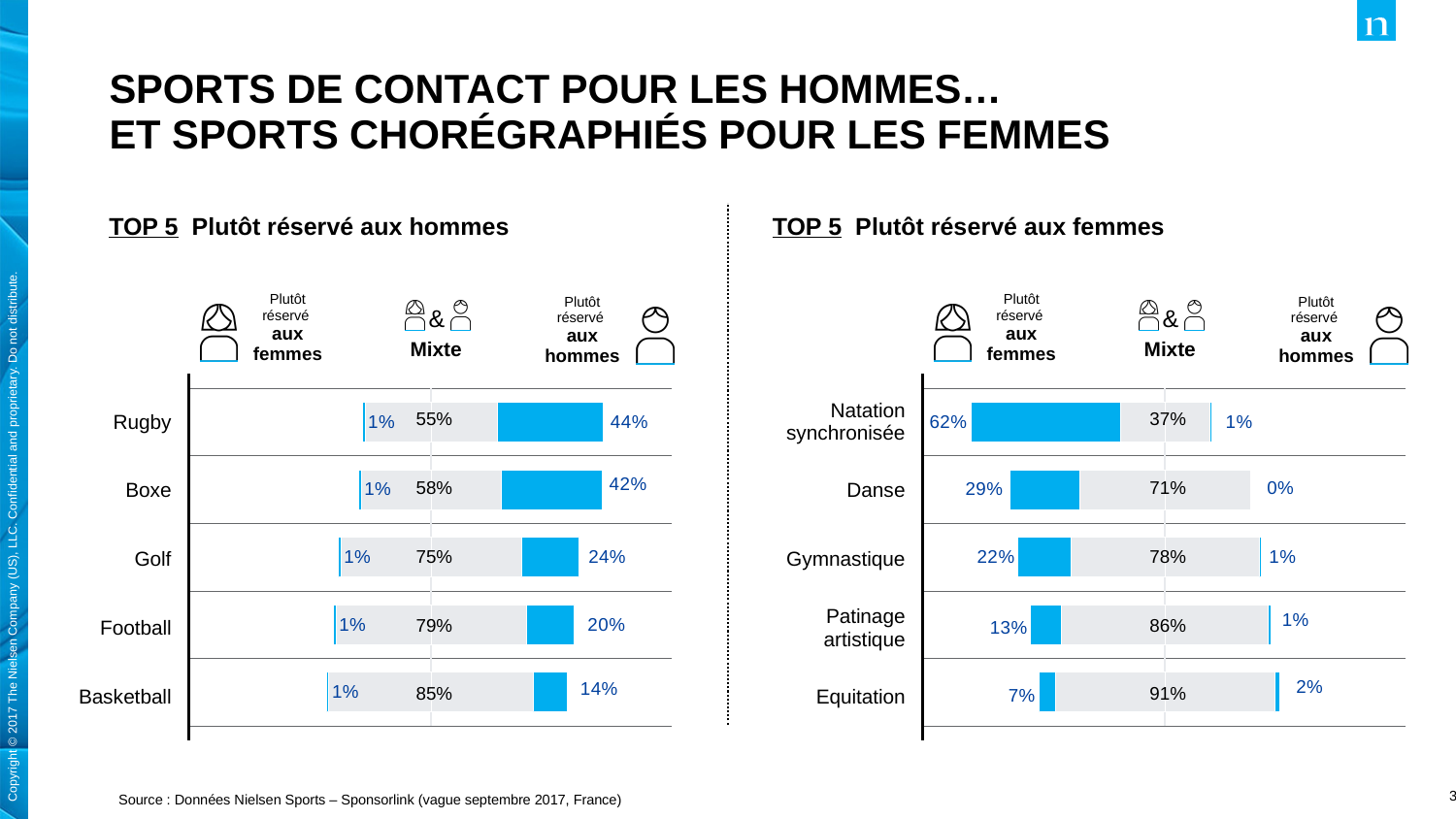
In the 'TOP 5 Plutôt réservé aux femmes' chart, what is the 'Plutôt réservé aux femmes' value for Natation synchronisée? 62% How many series does the legend of the 'TOP 5 Plutôt réservé aux hommes' chart list? 3 In the 'TOP 5 Plutôt réservé aux femmes' chart, which sport has the lowest 'Plutôt réservé aux femmes' value? Equitation How many sports are shown in the 'TOP 5 Plutôt réservé aux femmes' chart? 5 In the 'TOP 5 Plutôt réservé aux hommes' chart, what is the 'Plutôt réservé aux hommes' value for Rugby? 44% What kind of chart is the 'TOP 5 Plutôt réservé aux hommes' chart? Stacked bar chart In the 'TOP 5 Plutôt réservé aux femmes' chart, what is the 'Mixte' value for Equitation? 91% In the 'TOP 5 Plutôt réservé aux femmes' chart, which has a larger 'Mixte' value, Danse or Gymnastique? Gymnastique In the 'TOP 5 Plutôt réservé aux femmes' chart, what is the total of the three values for Danse? 100% In the 'TOP 5 Plutôt réservé aux hommes' chart, which sport has the highest 'Plutôt réservé aux hommes' value? Rugby In the 'TOP 5 Plutôt réservé aux hommes' chart, what is the 'Mixte' value for Basketball? 85% In the 'TOP 5 Plutôt réservé aux hommes' chart, what is the difference between the 'Plutôt réservé aux hommes' values for Boxe and Golf? 18%